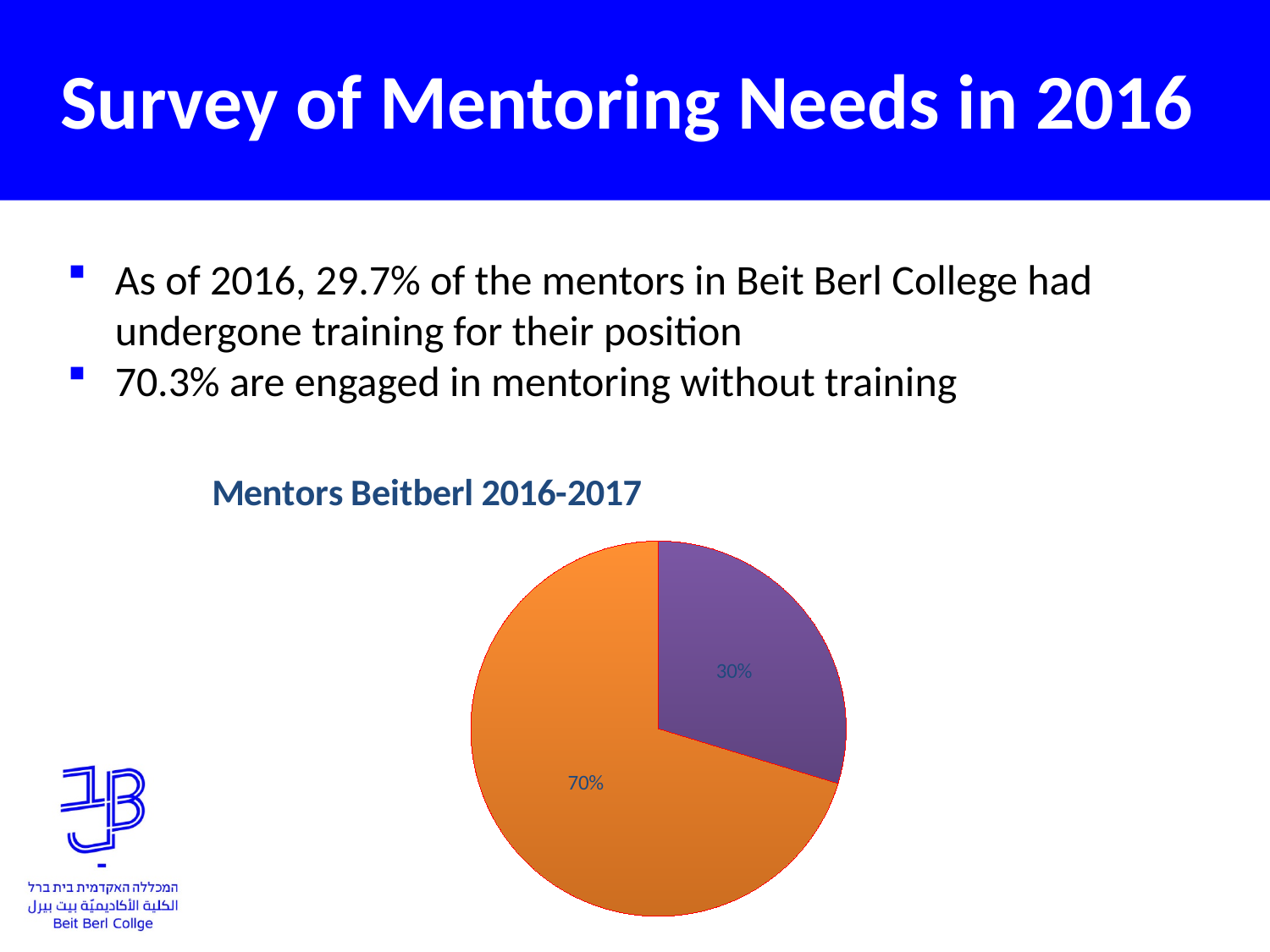
What is the value of the smallest slice in the pie chart? 30% What is the value of the largest slice in the pie chart? 70% What colour is the largest slice of the pie chart? orange By how many percentage points does the larger slice exceed the smaller slice in the pie chart? 40 What percentage is shown on the orange slice of the pie chart? 70% What is the title of the chart on the slide? Mentors Beitberl 2016-2017 What percentage is shown on the purple slice of the pie chart? 30% Which slice is larger in the pie chart, the orange one or the purple one? orange What kind of chart is shown on the slide? pie chart What share of the pie does the purple slice represent? 30% How many slices does the pie chart have? 2